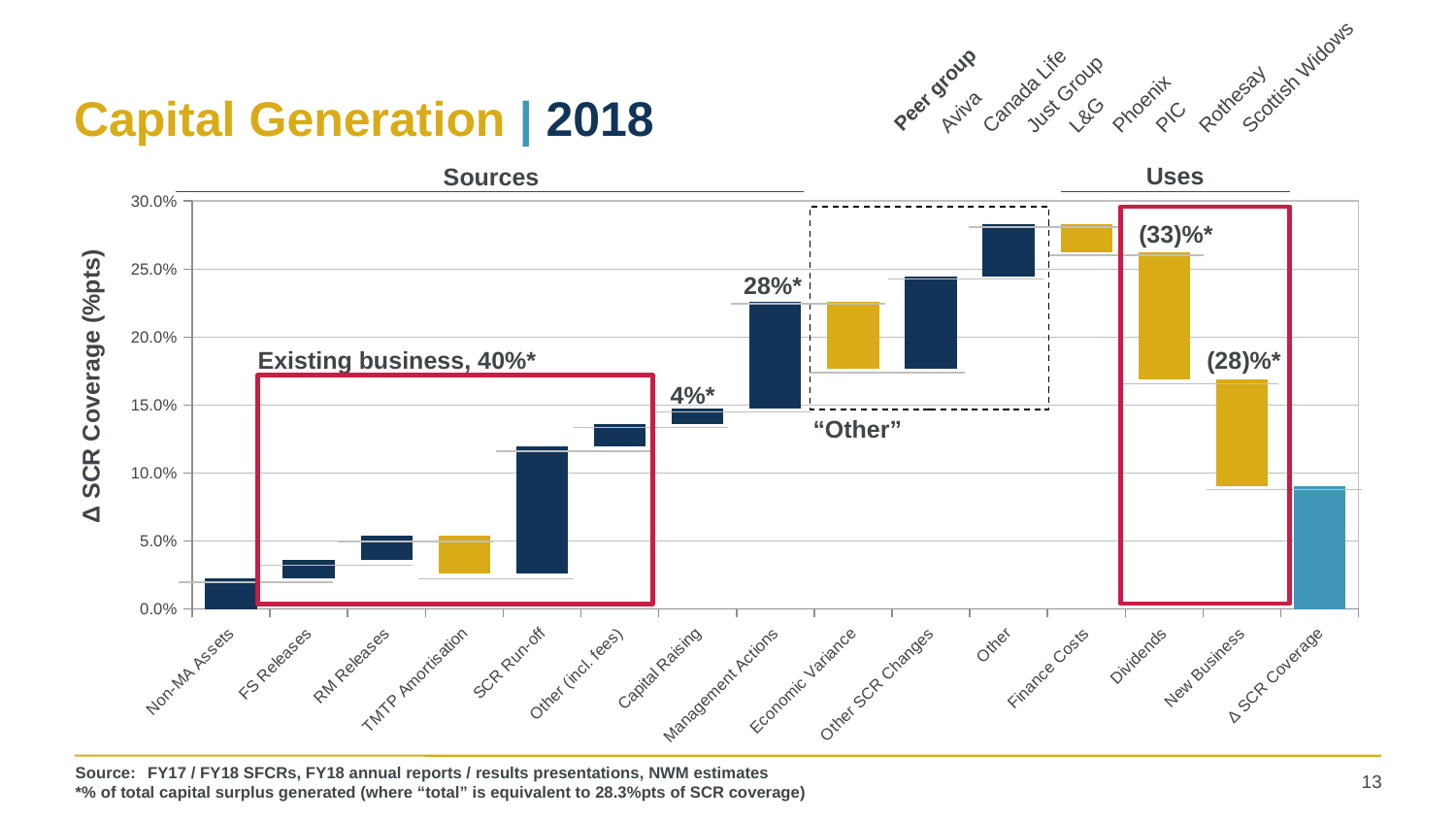
What percentage annotation is printed above the Management Actions bar? 28%* How many categories are shown along the x axis? 15 What percentage annotation is printed above the Dividends bar? (33)%* Which bar is taller, SCR Run-off or Non-MA Assets? SCR Run-off Is the value of the final Δ SCR Coverage bar greater or less than 10.0%? less Among the Sources bars, which category has the tallest bar? SCR Run-off What is the label on the y axis? Δ SCR Coverage (%pts) What kind of chart is shown on the slide? bar chart Is the top of the Management Actions bar greater or less than 20.0%? greater What percentage annotation is printed above the New Business bar? (28)%* What annotation is shown for the red box grouping the Sources bars from FS Releases to Other (incl. fees)? Existing business, 40%* What percentage annotation is printed above the Capital Raising bar? 4%*